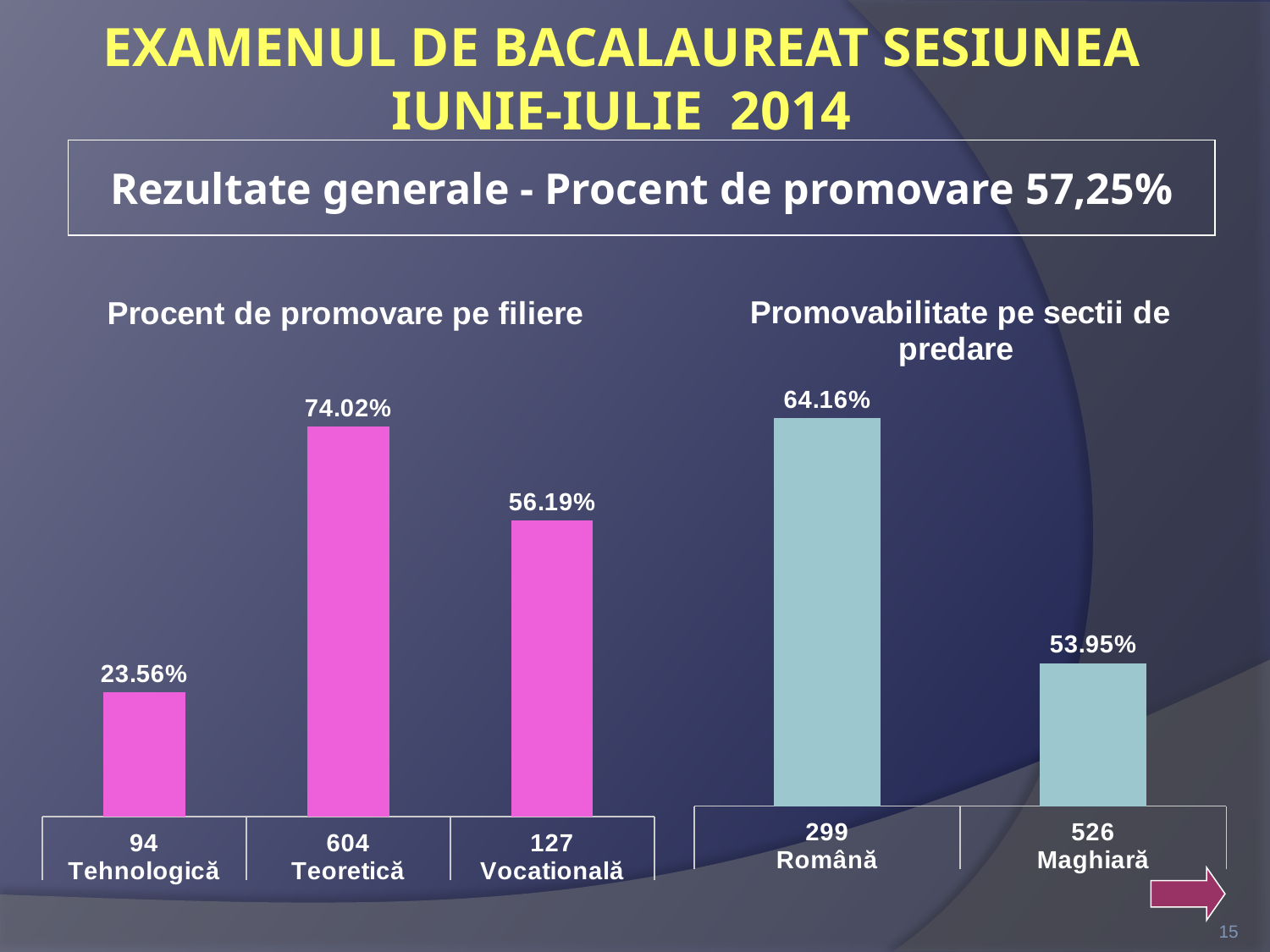
In the chart 'Procent de promovare pe filiere', what is the value for Vocațională? 56.19% In the chart 'Procent de promovare pe filiere', which category has the lowest value? Tehnologică In the chart 'Promovabilitate pe sectii de predare', what is the difference between the values for Română and Maghiară? 10.21% What kind of chart is 'Promovabilitate pe sectii de predare'? Bar chart In the chart 'Promovabilitate pe sectii de predare', what is the value for Română? 64.16% In the chart 'Procent de promovare pe filiere', how many categories are shown? 3 In the chart 'Procent de promovare pe filiere', what is the difference between the values for Teoretică and Vocațională? 17.83% In the chart 'Promovabilitate pe sectii de predare', which is larger, Română or Maghiară? Română In the chart 'Procent de promovare pe filiere', what is the value for Teoretică? 74.02% In the chart 'Procent de promovare pe filiere', what is the value for Tehnologică? 23.56% In the chart 'Promovabilitate pe sectii de predare', what is the value for Maghiară? 53.95% In the chart 'Procent de promovare pe filiere', which category has the highest value? Teoretică